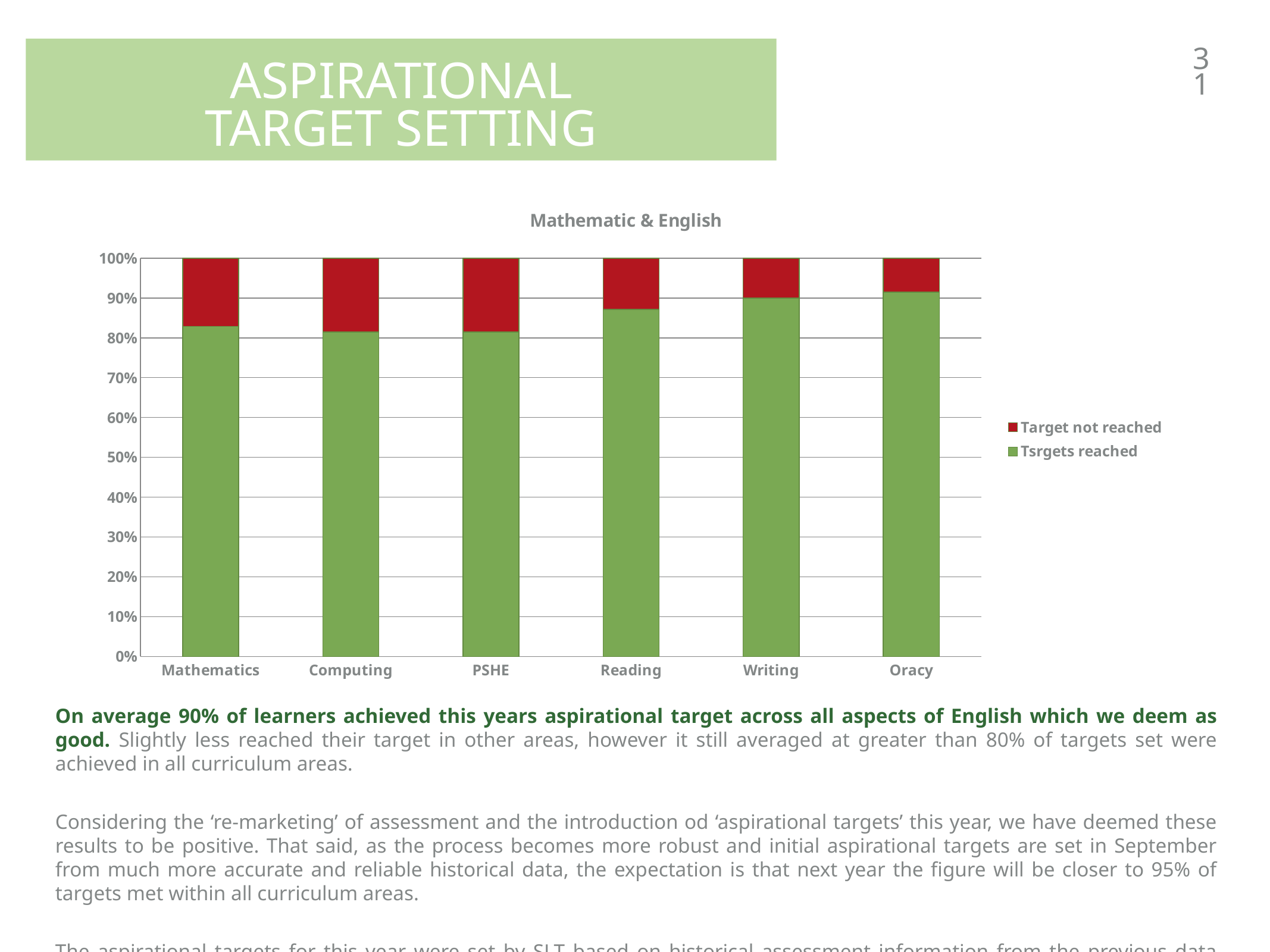
Is the 'Tsrgets reached' value for Reading greater or less than 90%? less Which has the larger 'Target not reached' share, PSHE or Writing? PSHE Is the 'Tsrgets reached' value for Mathematics greater or less than 80%? greater How many series does the chart legend list? 2 How many categories are shown on the x axis of the chart? 6 Which has the larger 'Tsrgets reached' share, Reading or Mathematics? Reading Is the 'Tsrgets reached' value for Oracy greater or less than 90%? greater What type of chart is shown on the slide? Stacked bar chart Which series is shown in red in the chart? Target not reached What is the total of the stacked bar for Writing? 100% What is the title of the chart? Mathematic & English